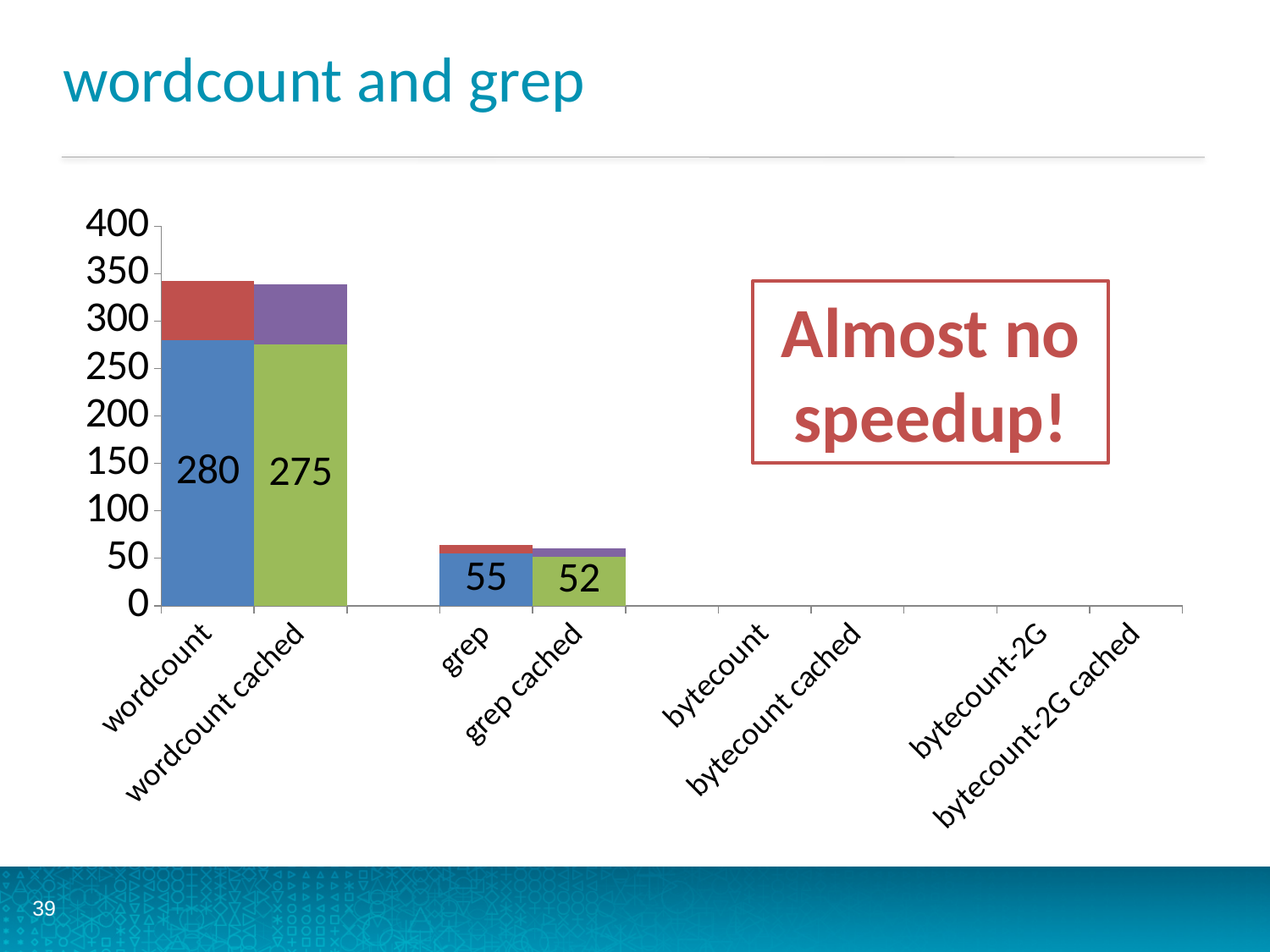
What is the labeled value on the grep bar? 55 What does the red text box on the slide say? Almost no speedup! What is the labeled value on the wordcount bar? 280 Is the total height of the wordcount bar greater or less than 300? greater How many category labels are shown on the x axis? 8 What kind of chart is shown on the slide? bar chart Is the total height of the grep cached bar greater or less than 100? less What is the labeled value on the wordcount cached bar? 275 What is the labeled value on the grep cached bar? 52 What is the difference between the labeled values for grep and grep cached? 3 Which has a larger labeled value, wordcount or grep? wordcount What is the difference between the labeled values for wordcount and wordcount cached? 5